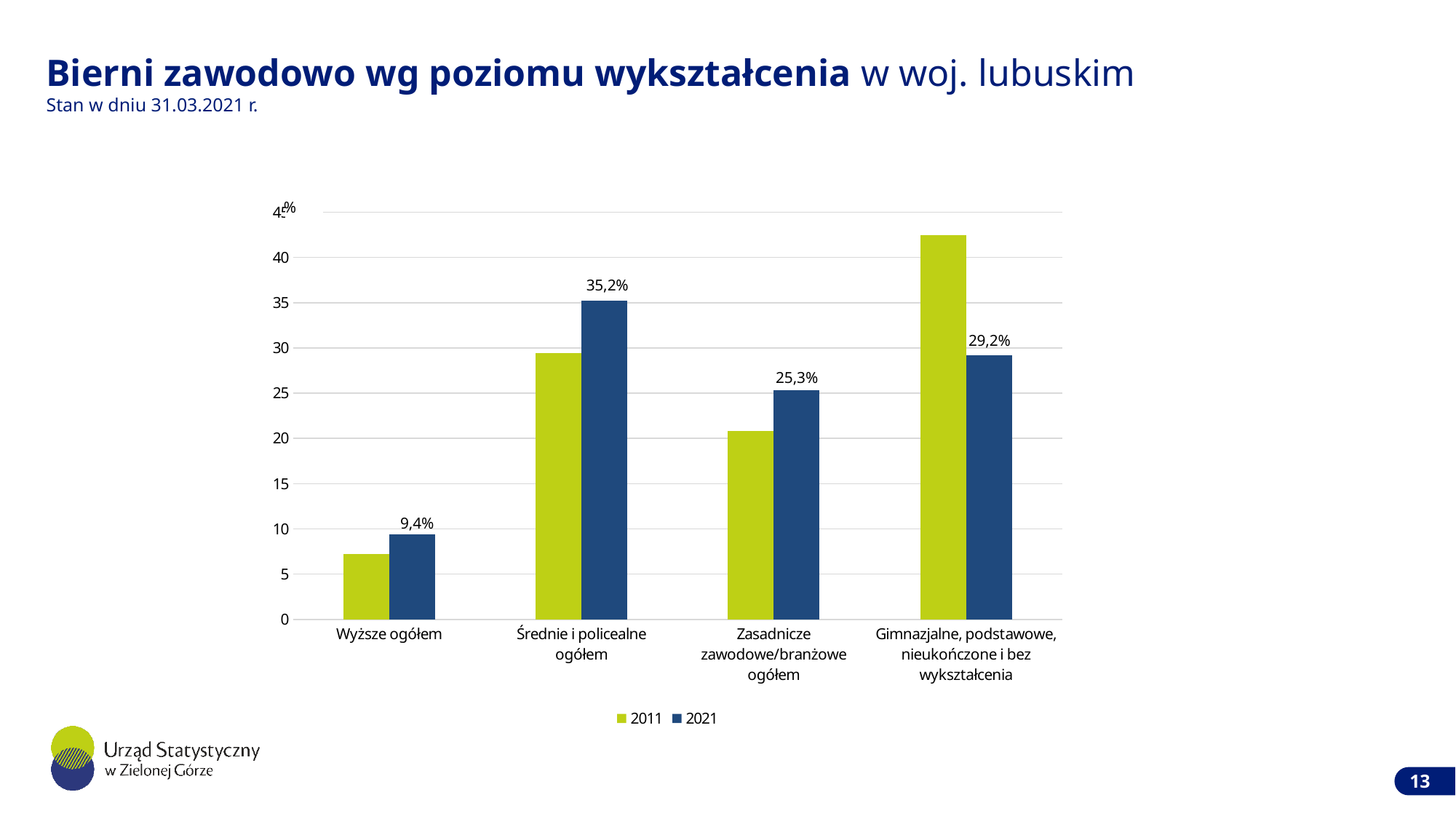
How many categories are shown on the x axis? 4 How many series does the legend list? 2 Which category has the highest value for 2021? Średnie i policealne ogółem What is the value for 2021 in the Gimnazjalne, podstawowe, nieukończone i bez wykształcenia category? 29,2% What is the value for 2021 in the Wyższe ogółem category? 9,4% In the Gimnazjalne, podstawowe, nieukończone i bez wykształcenia category, which series has the larger value, 2011 or 2021? 2011 What is the difference between the 2021 values for Średnie i policealne ogółem and Gimnazjalne, podstawowe, nieukończone i bez wykształcenia? 6,0 percentage points Is the 2011 value for Gimnazjalne, podstawowe, nieukończone i bez wykształcenia greater or less than 40? greater What is the value for 2021 in the Zasadnicze zawodowe/branżowe ogółem category? 25,3% Which category has the highest value for 2011? Gimnazjalne, podstawowe, nieukończone i bez wykształcenia What is the value for 2021 in the Średnie i policealne ogółem category? 35,2% Which category has the lowest value for 2021? Wyższe ogółem